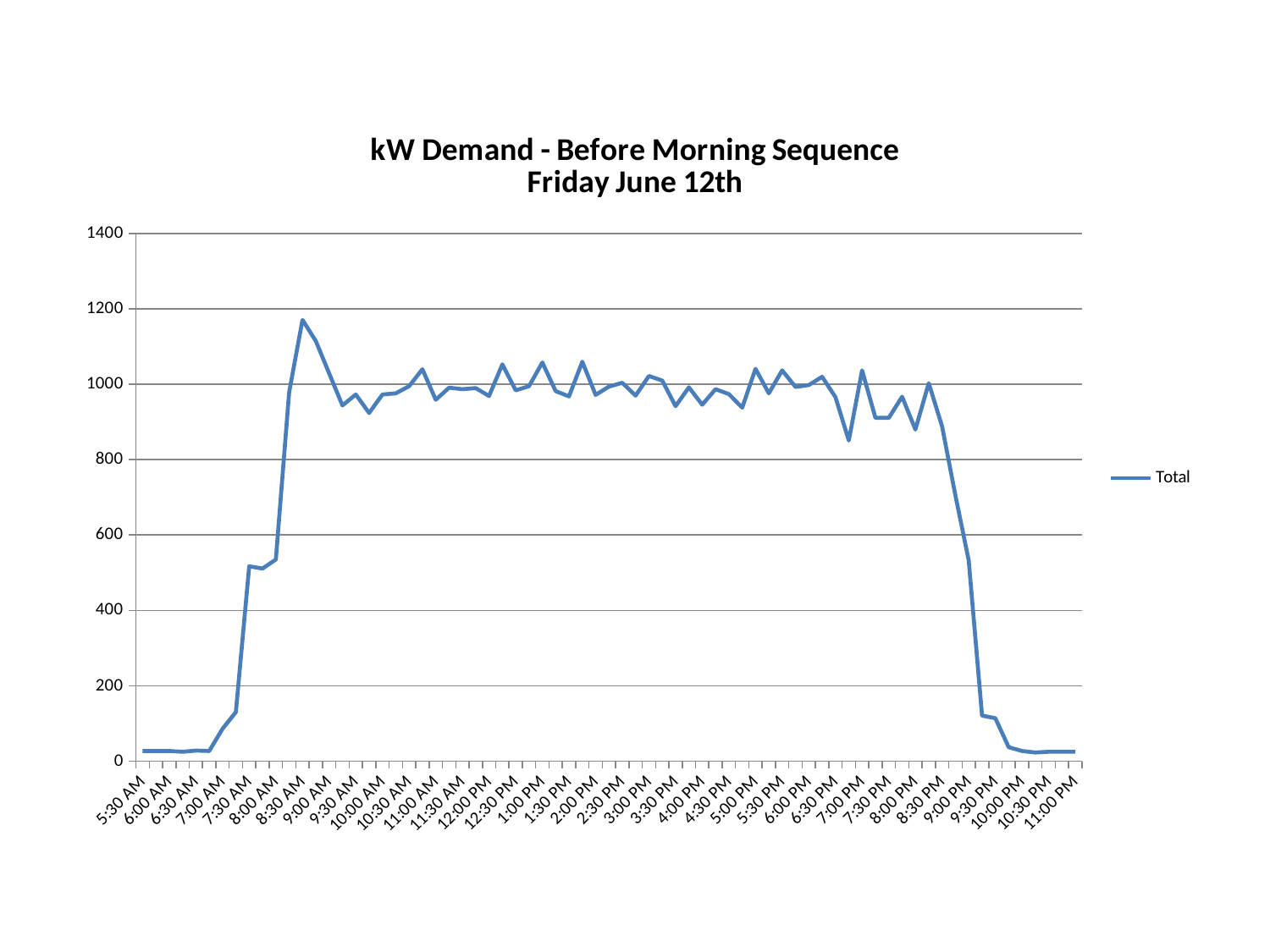
Is the value for 3:00 PM greater or less than 800? greater Is the value for 12:00 PM greater or less than 800? greater Is the value for 11:00 PM greater or less than 200? less What kind of chart is shown on the slide? line chart What is the name of the series shown in the legend? Total How many series does the legend list? 1 Does the line rise or fall between 5:30 AM and 8:30 AM? rise Which is larger, the value at 5:30 AM or the value at 12:00 PM? 12:00 PM What is the title of the chart? kW Demand - Before Morning Sequence Friday June 12th